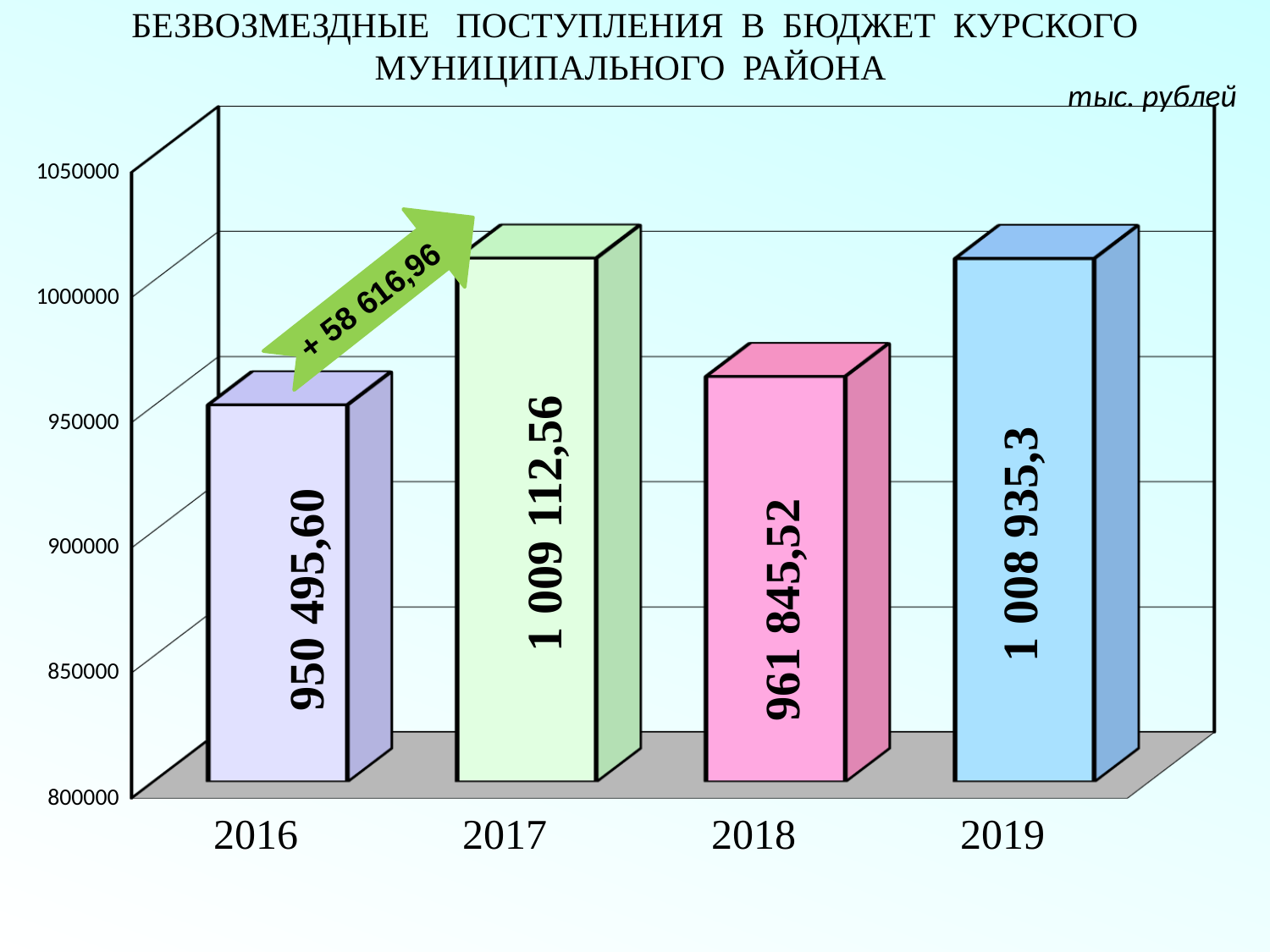
What is the value for 2018? 961 845,52 In what units are the values on the chart given, according to the label at the top right? тыс. рублей What is the difference between the values for 2017 and 2016? 58 616,96 Is the value for 2018 greater or less than 1000000? less What is the difference between the values for 2018 and 2016? 11 349,92 What kind of chart is shown on the slide? bar chart What is the value for 2019? 1 008 935,3 Which is larger, the value for 2017 or the value for 2018? 2017 What is the value for 2017? 1 009 112,56 Which year has the lowest value? 2016 How many years are shown on the chart? 4 What is the value for 2016? 950 495,60